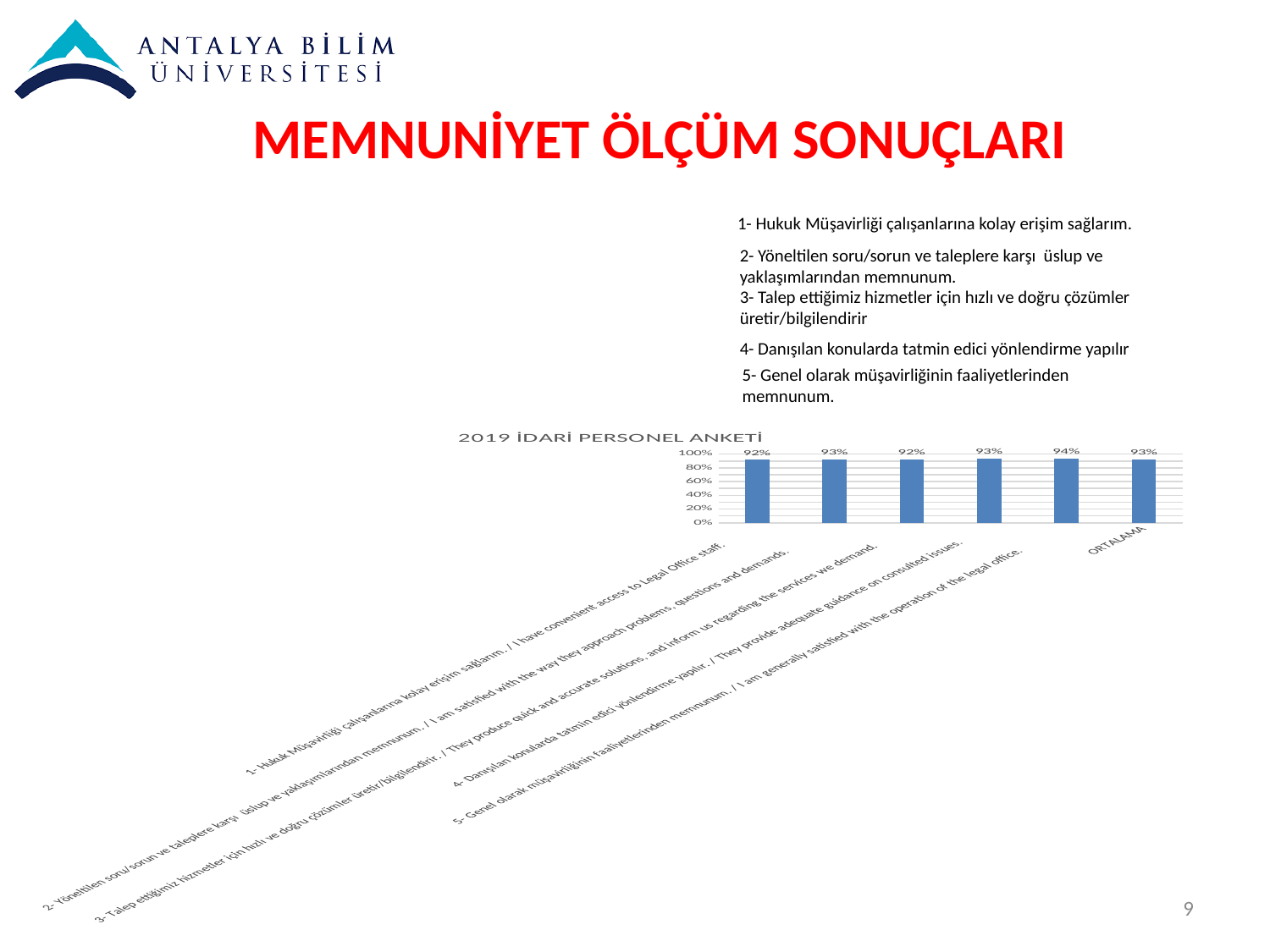
What is the title of the chart? 2019 İDARİ PERSONEL ANKETİ Which is larger: the value for category 5 or the value for category 3? Category 5 What is the value for category 4 (Danışılan konularda tatmin edici yönlendirme yapılır) in the chart? 93% What is the value for category 1 (Hukuk Müşavirliği çalışanlarına kolay erişim sağlarım) in the chart? 92% What kind of chart is shown on the slide? Bar chart What is the value for category 5 (Genel olarak müşavirliğinin faaliyetlerinden memnunum) in the chart? 94% How many bars are shown in the chart? 6 Is the value for ORTALAMA greater or less than 80%? greater What is the lowest value shown in the chart? 92% What is the value for ORTALAMA in the chart? 93% What is the difference between the value for category 5 and the value for ORTALAMA? 1% Which category has the highest value in the chart? 5- Genel olarak müşavirliğinin faaliyetlerinden memnunum